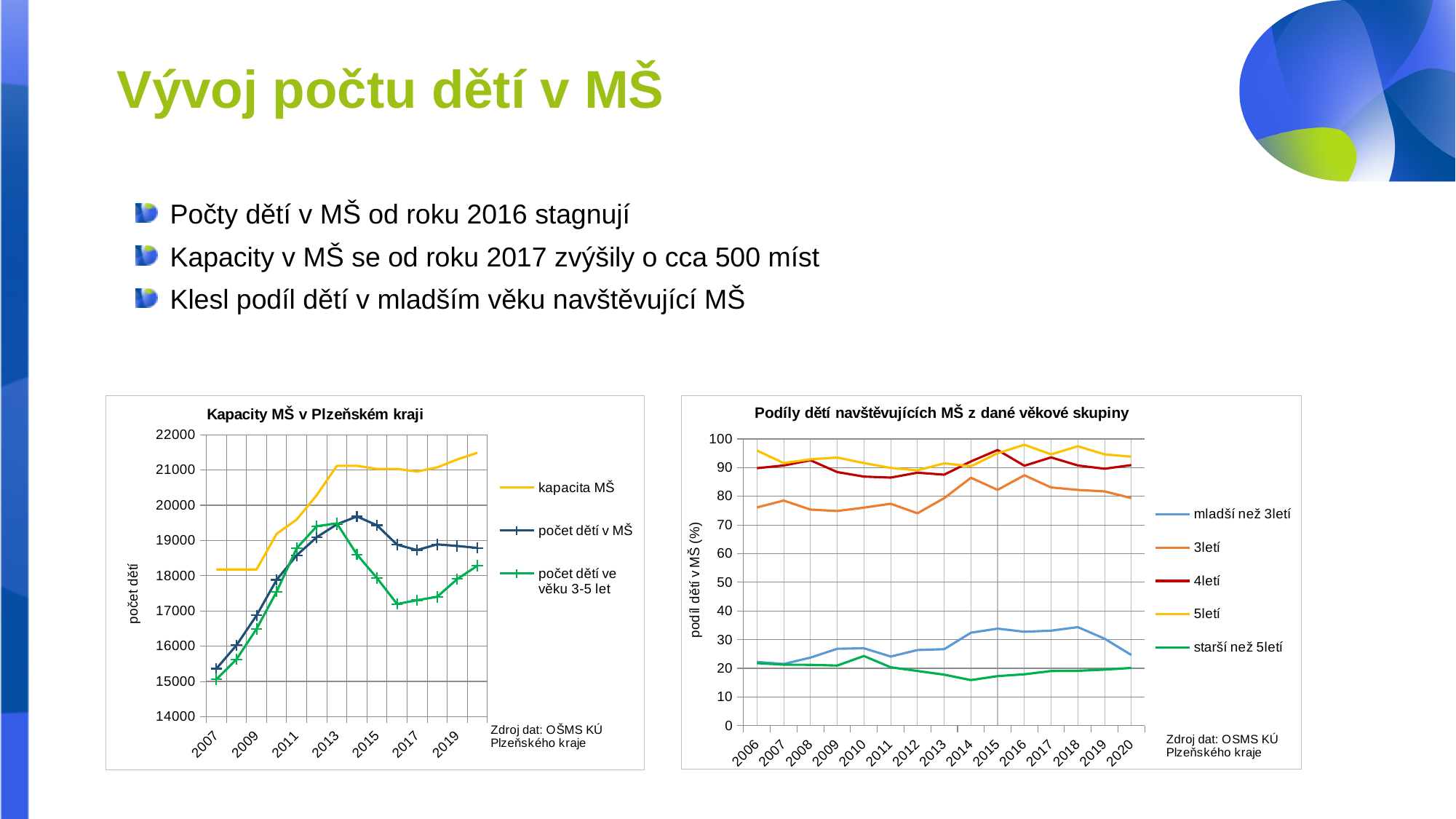
In the right chart 'Podíly dětí navštěvujících MŠ z dané věkové skupiny', which series has the larger value in 2020: '3letí' or 'mladší než 3letí'? 3letí In the left chart 'Kapacity MŠ v Plzeňském kraji', is the value of 'počet dětí v MŠ' in 2007 greater or less than 16000? less In the left chart 'Kapacity MŠ v Plzeňském kraji', does the 'kapacita MŠ' line rise or fall between 2007 and 2013? rise In the right chart 'Podíly dětí navštěvujících MŠ z dané věkové skupiny', is the value for 'mladší než 3letí' in 2018 greater or less than 30? greater In the left chart 'Kapacity MŠ v Plzeňském kraji', is the value of 'kapacita MŠ' in 2020 greater or less than 21000? greater In the right chart 'Podíly dětí navštěvujících MŠ z dané věkové skupiny', how many years are labelled on the x axis? 15 What type of chart is the left chart titled 'Kapacity MŠ v Plzeňském kraji'? line chart What is the y-axis label of the right chart 'Podíly dětí navštěvujících MŠ z dané věkové skupiny'? podíl dětí v MŠ (%) How many series does the legend of the right chart 'Podíly dětí navštěvujících MŠ z dané věkové skupiny' list? 5 How many series does the legend of the left chart 'Kapacity MŠ v Plzeňském kraji' list? 3